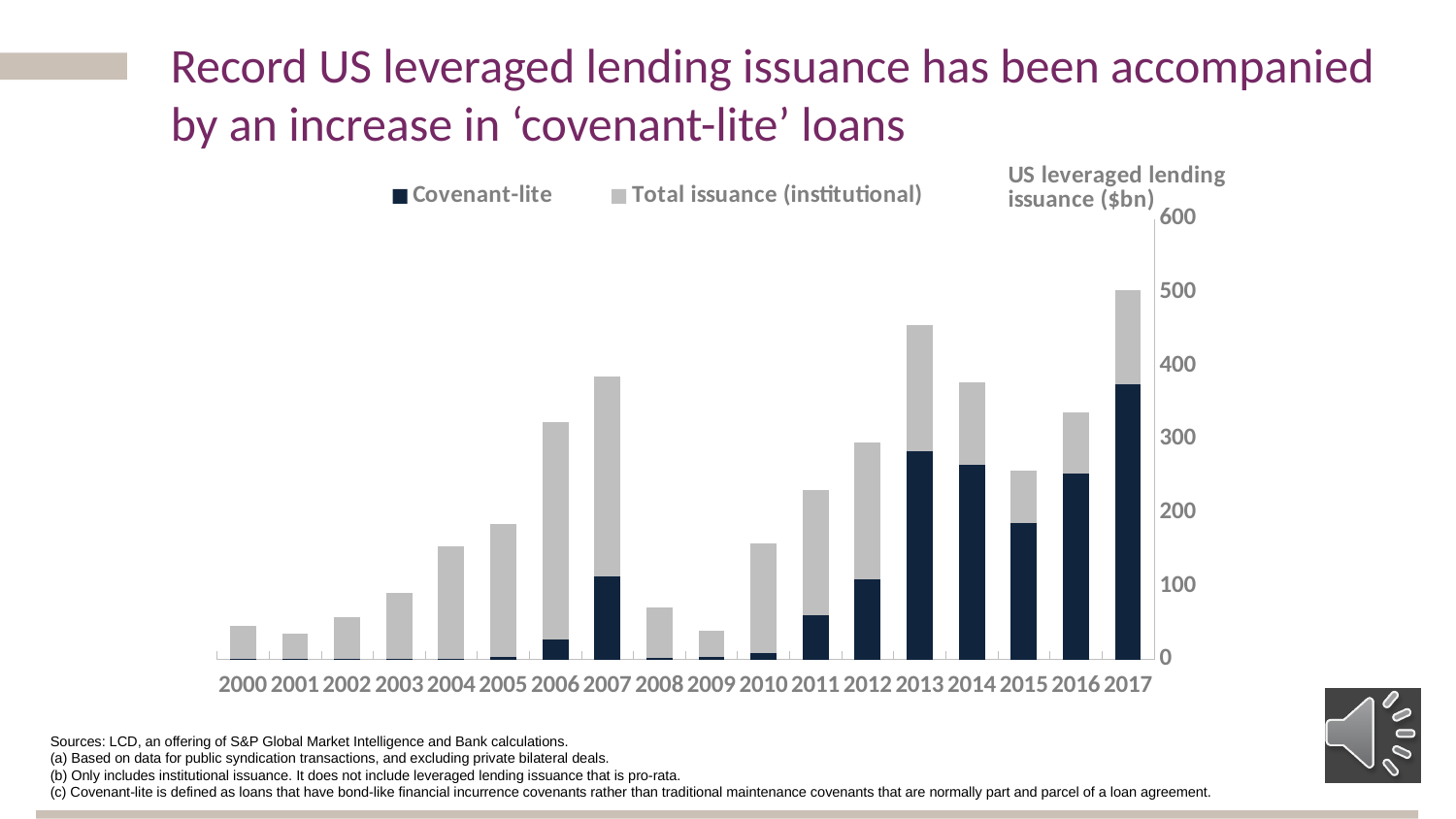
Which year has the larger total bar, 2013 or 2014? 2013 How many years are shown along the x axis? 18 Does the Covenant-lite value rise or fall from 2010 to 2013? rise Which year has the highest total bar? 2017 What kind of chart is shown on the slide? Stacked bar chart Is the total bar for 2008 greater or less than 100? less Is the Covenant-lite value for 2013 greater or less than 200? greater How many series does the legend list? 2 Which year has the highest Covenant-lite value? 2017 Is the total bar for 2017 greater or less than 400? greater What is the title of the vertical axis? US leveraged lending issuance ($bn)